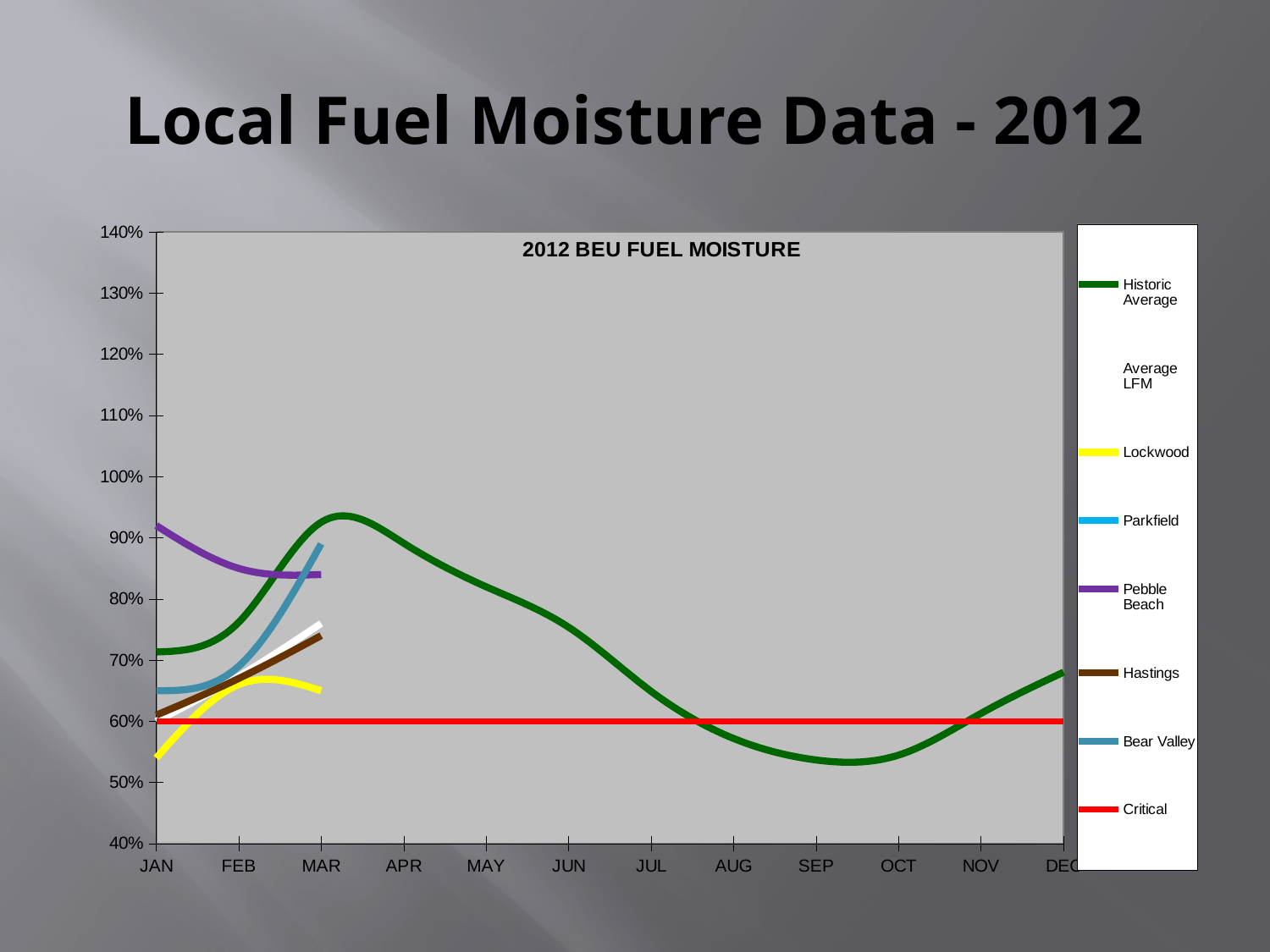
What kind of chart is shown on the slide? Line chart At what value does the flat Critical line sit on the y axis? 60% How many months are labelled along the x axis? 12 Which series has the highest value in JAN? Pebble Beach Is the value for Historic Average in SEP greater or less than 60%? less Is the value for Lockwood in JAN greater or less than 60%? less Is the value for Pebble Beach in JAN greater or less than 80%? greater How many series does the chart legend list? 8 What colour is the Critical line in the chart? Red Does the Historic Average line rise or fall from APR to SEP? Fall What is the title printed inside the chart area? 2012 BEU FUEL MOISTURE